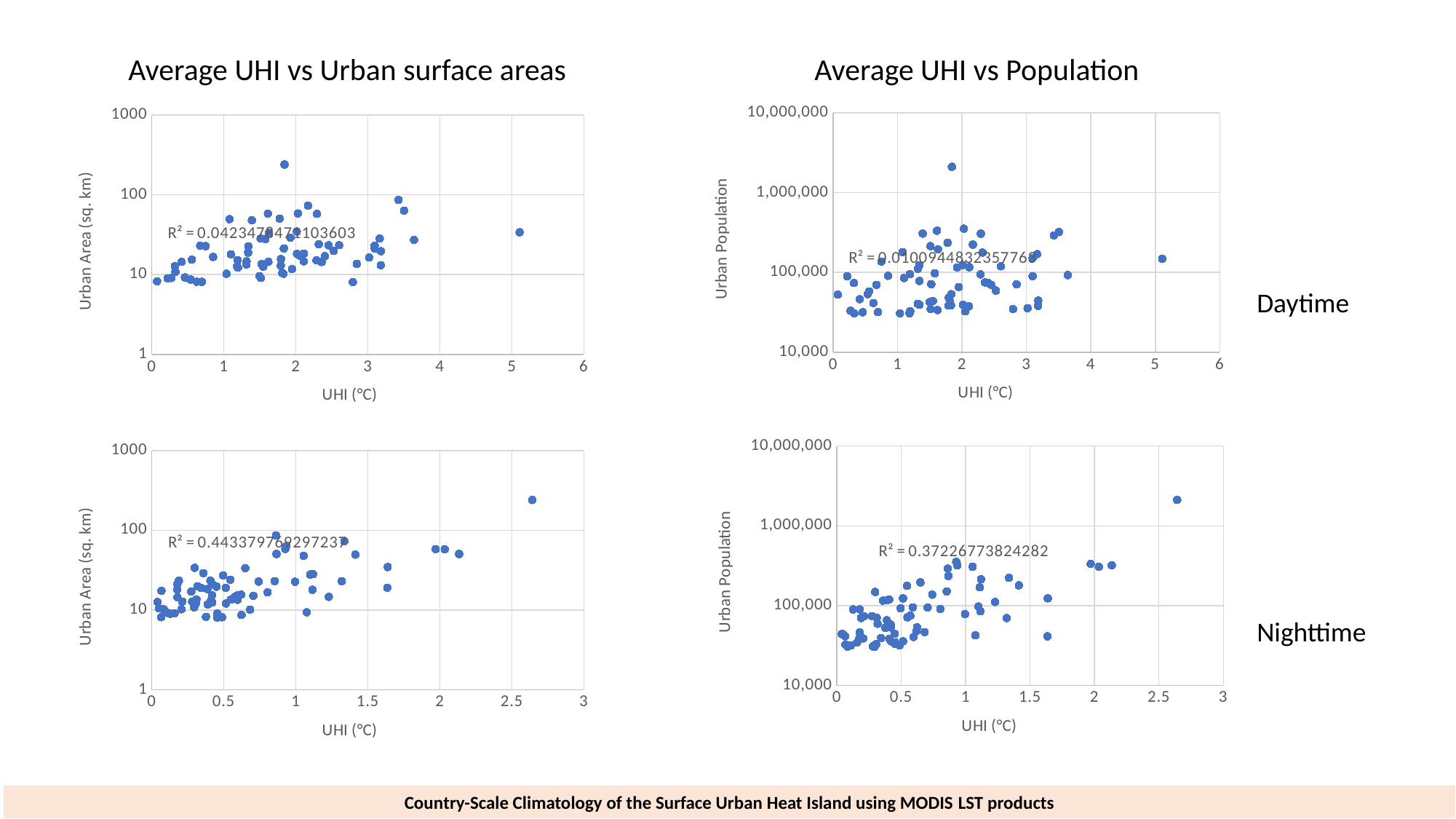
In the top-left chart (Daytime, Average UHI vs Urban surface areas), is the urban area of the point at a UHI of about 5 greater or less than 100 sq. km? less In the bottom-right chart (Nighttime, Average UHI vs Population), is the population of the point at a UHI of about 2.6 greater or less than 1,000,000? greater What kind of chart is the top-left chart titled 'Average UHI vs Urban surface areas'? scatter chart In the top-right chart (Daytime, Average UHI vs Population), is the population of the highest point greater or less than 1,000,000? greater What is the x-axis label shared by all four charts on the slide? UHI (°C) In the bottom-right chart (Nighttime, Average UHI vs Population), what R² value is printed? R² = 0.37226773824282 What is the y-axis label of the top-right chart titled 'Average UHI vs Population'? Urban Population In the bottom-left chart (Nighttime, Average UHI vs Urban surface areas), do the urban area values generally rise or fall as UHI increases? rise